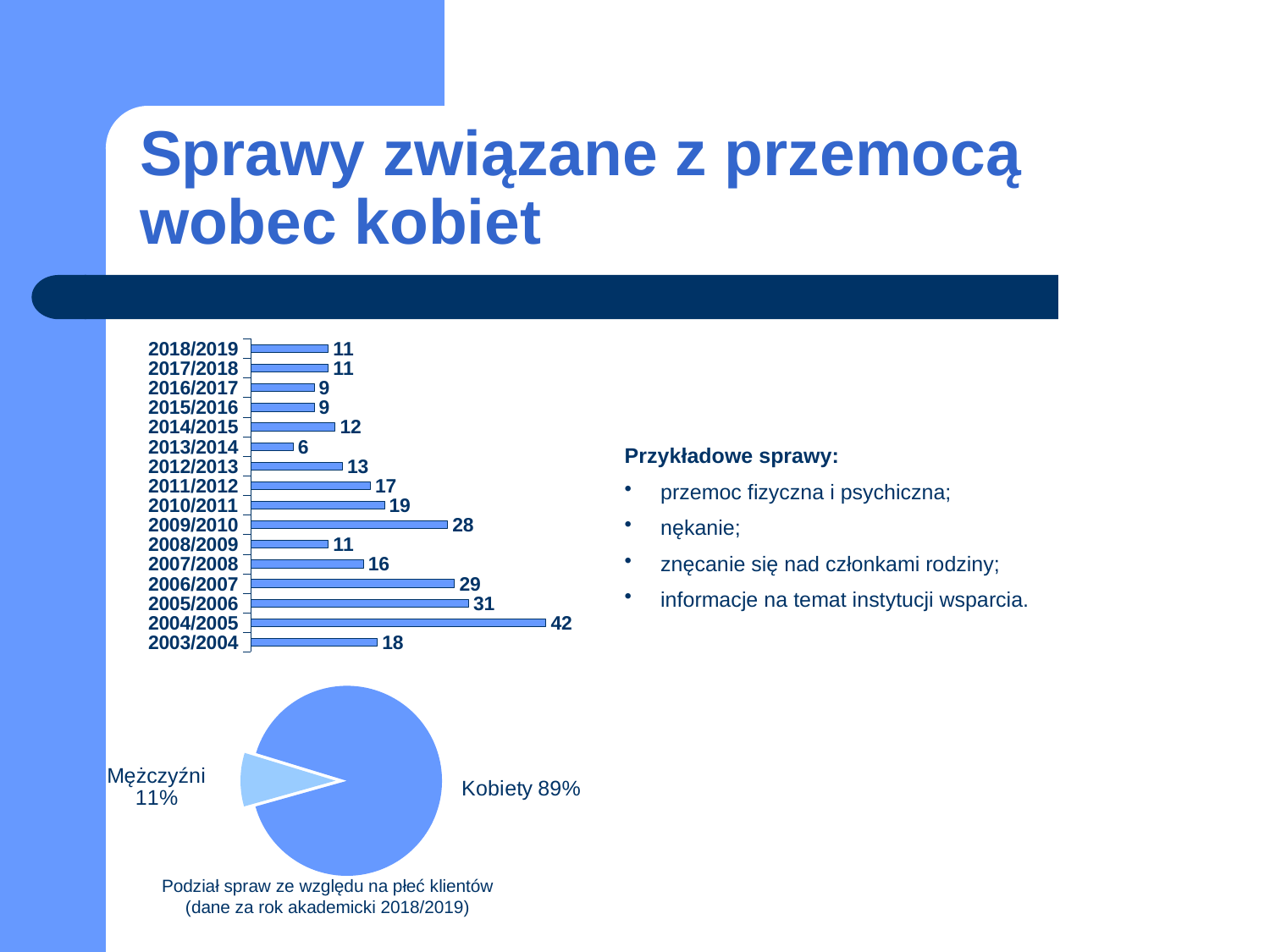
What type of chart is the chart at the top left of the slide? bar chart In the pie chart at the bottom left, what share is labelled Mężczyźni? 11% In the bar chart at the top left, how many academic years are shown? 16 In the pie chart at the bottom left, what share is labelled Kobiety? 89% What is the caption below the pie chart at the bottom left? Podział spraw ze względu na płeć klientów (dane za rok akademicki 2018/2019) In the bar chart at the top left, which is larger: the value for 2010/2011 or the value for 2007/2008? 2010/2011 In the bar chart at the top left, which academic year has the lowest value? 2013/2014 In the bar chart at the top left, which academic year has the highest value? 2004/2005 In the bar chart at the top left, what is the value for 2009/2010? 28 In the bar chart at the top left, what is the value for 2013/2014? 6 In the bar chart at the top left, what is the value for 2004/2005? 42 In the bar chart at the top left, what is the difference between the values for 2005/2006 and 2006/2007? 2